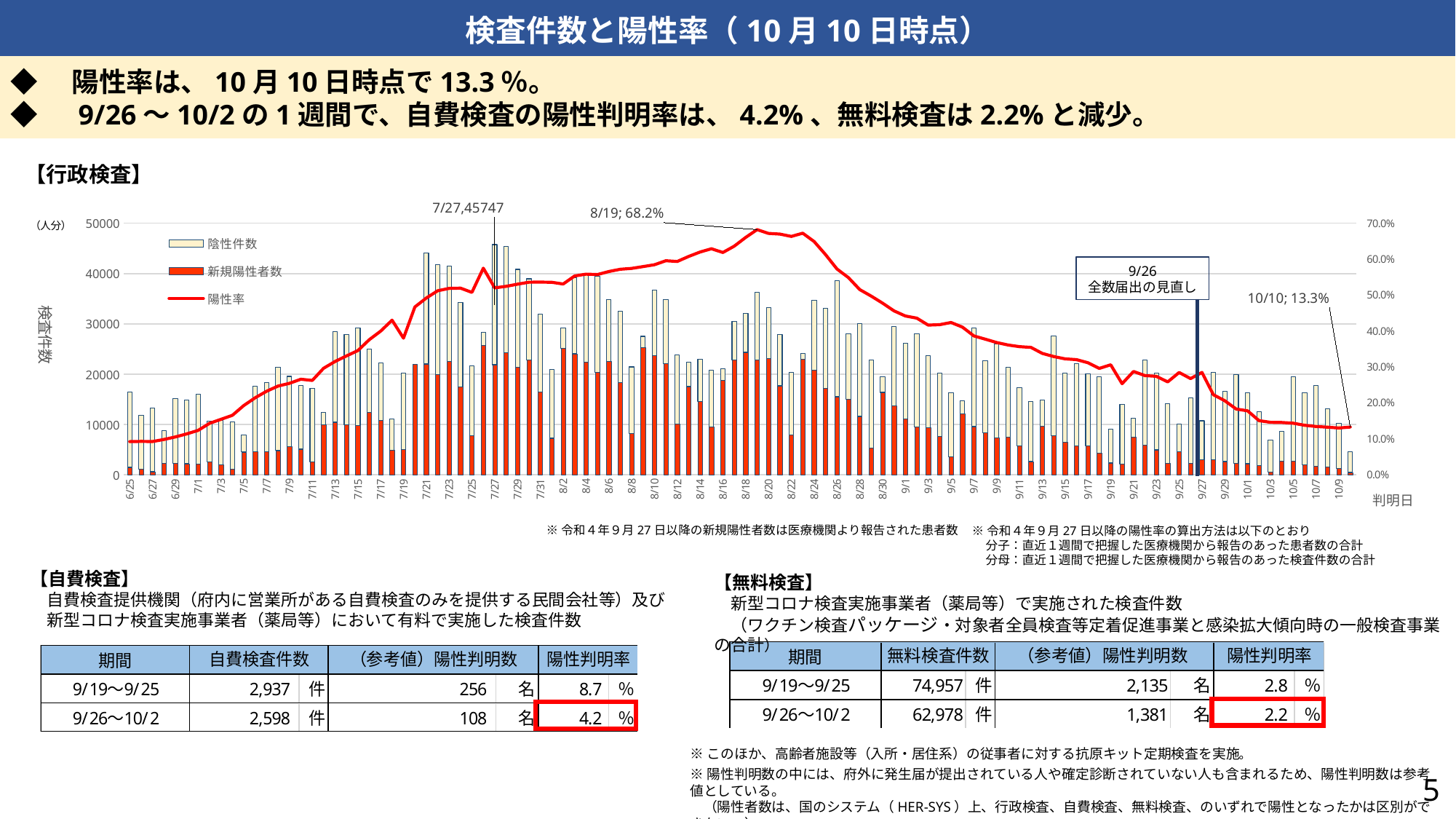
What is the test count value labelled for 7/27? 45747 How many series does the chart legend list? 3 What kind of chart is shown under 【行政検査】? Combination bar and line chart Does the 陽性率 line rise or fall between 8/19 and 10/10? Fall What is the 陽性率 value labelled for 10/10? 13.3% Which is larger, the 陽性率 on 8/19 or on 10/10? 8/19 Is the total test count bar for 7/27 greater or less than 40000? greater On which date does the 陽性率 line reach its highest value? 8/19 What is the peak value of the 陽性率 line shown on the chart? 68.2% What is the difference between the 陽性率 on 8/19 and on 10/10? 54.9% What text is in the annotation box pointing to 9/26 on the chart? 9/26 全数届出の見直し Is the 陽性率 value on 6/25 greater or less than 20.0%? less